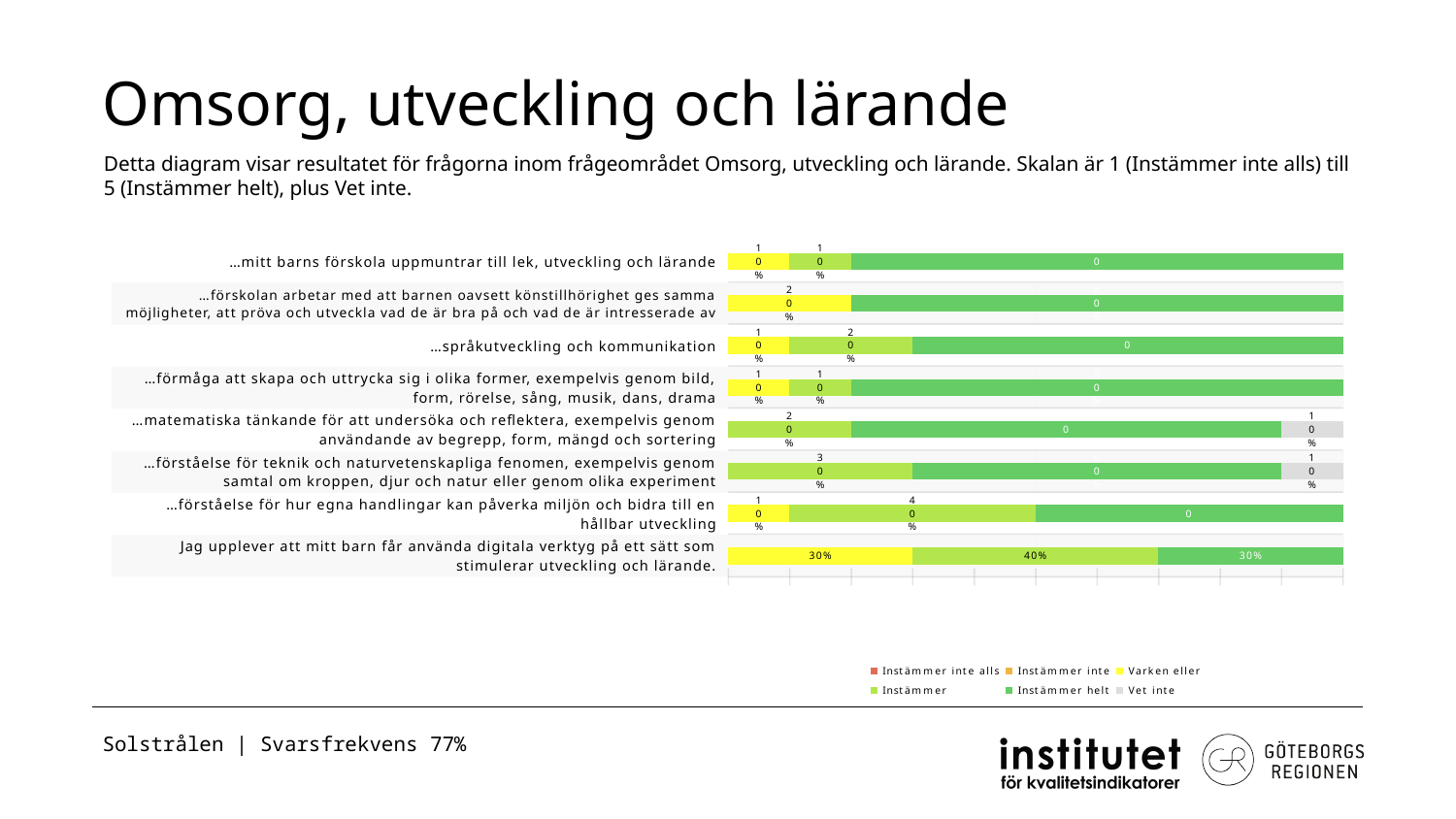
For the statement 'Jag upplever att mitt barn får använda digitala verktyg på ett sätt som stimulerar utveckling och lärande', what share answered 'Varken eller'? 30% What colour does the legend use for 'Vet inte'? Grey How many statements show a 'Vet inte' (grey) segment? 2 What kind of chart is shown on the slide? Stacked horizontal bar chart For the statement about digitala verktyg, what is the difference between the 'Instämmer' share (40%) and the 'Instämmer helt' share (30%)? 10% For the statement about digitala verktyg, which response has the larger share: 'Instämmer' or 'Varken eller'? Instämmer How many statements (bars) are plotted in the chart? 8 For the statement 'Jag upplever att mitt barn får använda digitala verktyg på ett sätt som stimulerar utveckling och lärande', what share answered 'Instämmer helt'? 30% For the statement 'Jag upplever att mitt barn får använda digitala verktyg på ett sätt som stimulerar utveckling och lärande', what share answered 'Instämmer'? 40% Which statement has the smallest 'Instämmer helt' (dark green) segment? Jag upplever att mitt barn får använda digitala verktyg på ett sätt som stimulerar utveckling och lärande. How many response categories does the legend list? 6 For the statement about digitala verktyg, what is the total of the three labelled segments (30%, 40%, 30%)? 100%